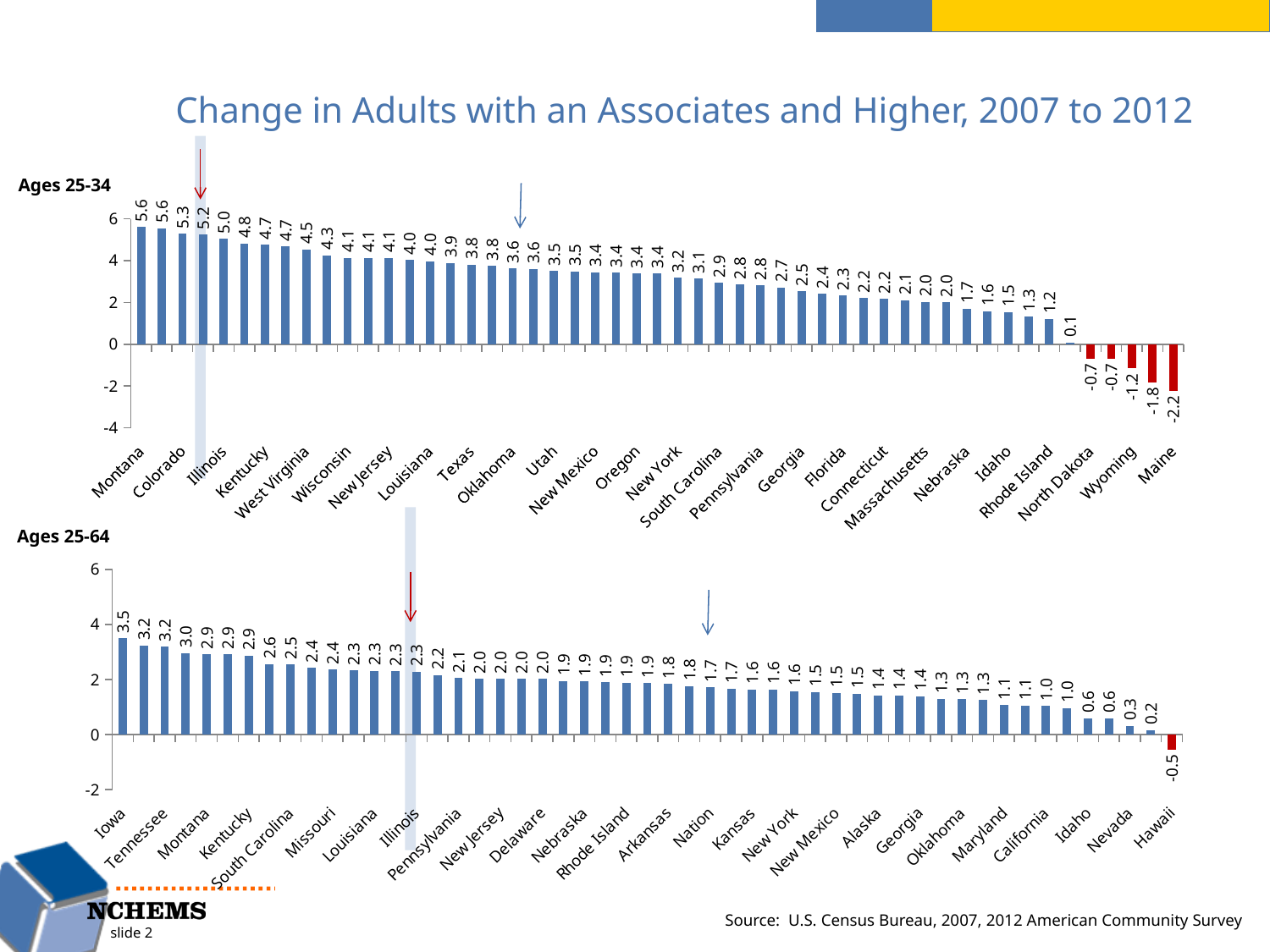
In the Ages 25-34 chart, what is the value for Montana? 5.6 In the Ages 25-34 chart, do the values rise or fall from left to right? Fall In the Ages 25-64 chart, which is larger, the value for Iowa or the value for Illinois? Iowa What type of chart is used for the Ages 25-64 data? Bar chart In the Ages 25-64 chart, what is the difference between the values for Iowa and Illinois? 1.2 In the Ages 25-64 chart, what is the lowest value shown? -0.5 In the Ages 25-64 chart, what is the value for Iowa? 3.5 In the Ages 25-34 chart, how many bars have negative values? 5 In the Ages 25-34 chart, is the value for Illinois greater or less than 4? greater In the Ages 25-34 chart, what is the highest value shown? 5.6 In the Ages 25-34 chart, what is the lowest value shown? -2.2 In the Ages 25-64 chart, what is the value for Illinois? 2.3